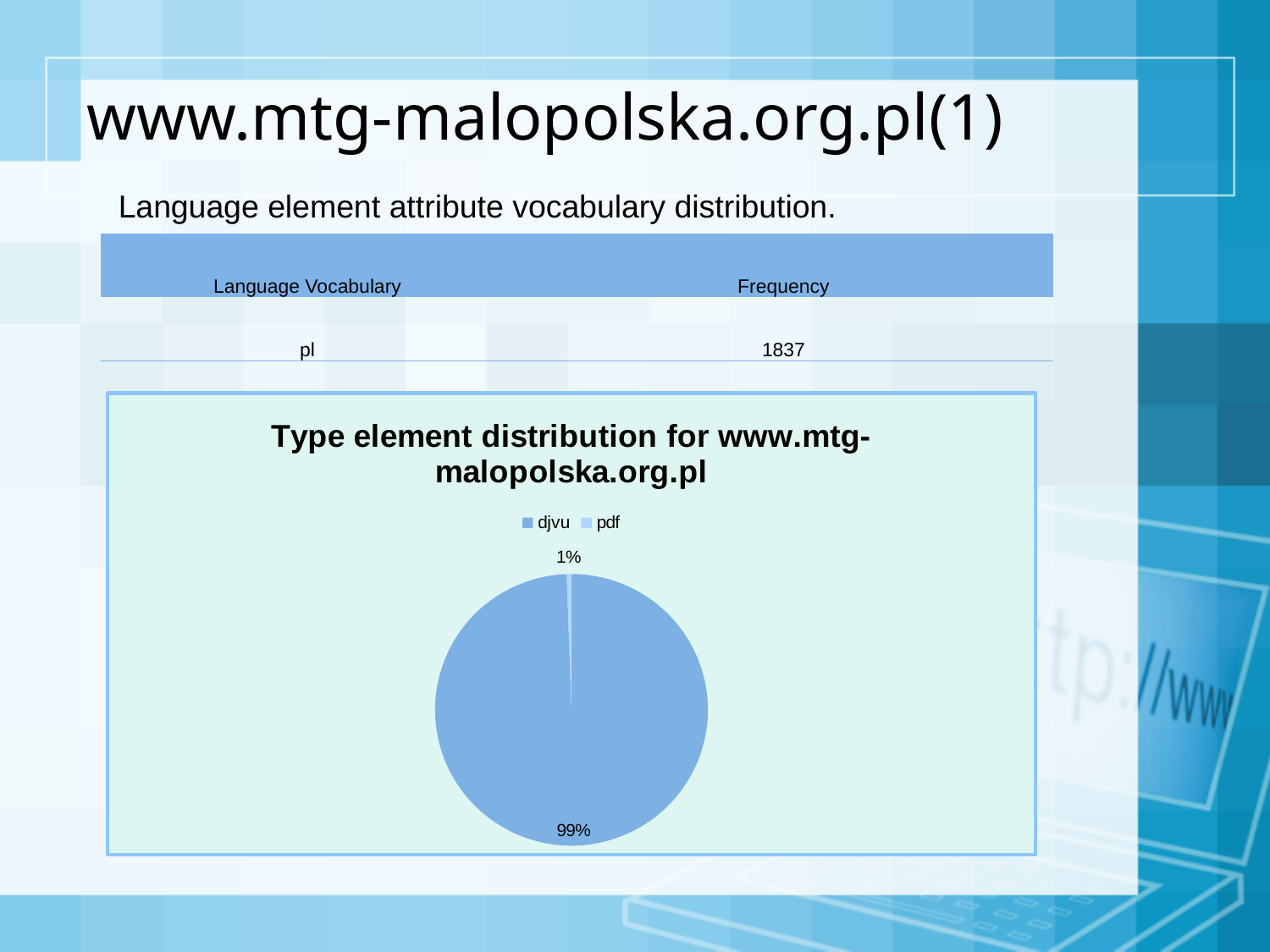
What is the difference in percentage points between the djvu share and the pdf share? 98 Which category has the smallest slice of the pie? pdf What is the title of the pie chart? Type element distribution for www.mtg-malopolska.org.pl Which categories are listed in the chart legend? djvu and pdf Which category has the largest slice of the pie? djvu What kind of chart is shown on the slide? pie chart How many entries does the chart legend list? 2 What share of the pie does pdf account for? 1% What share of the pie does djvu account for? 99% How many slices does the pie chart have? 2 Which is larger, the share for djvu or the share for pdf? djvu